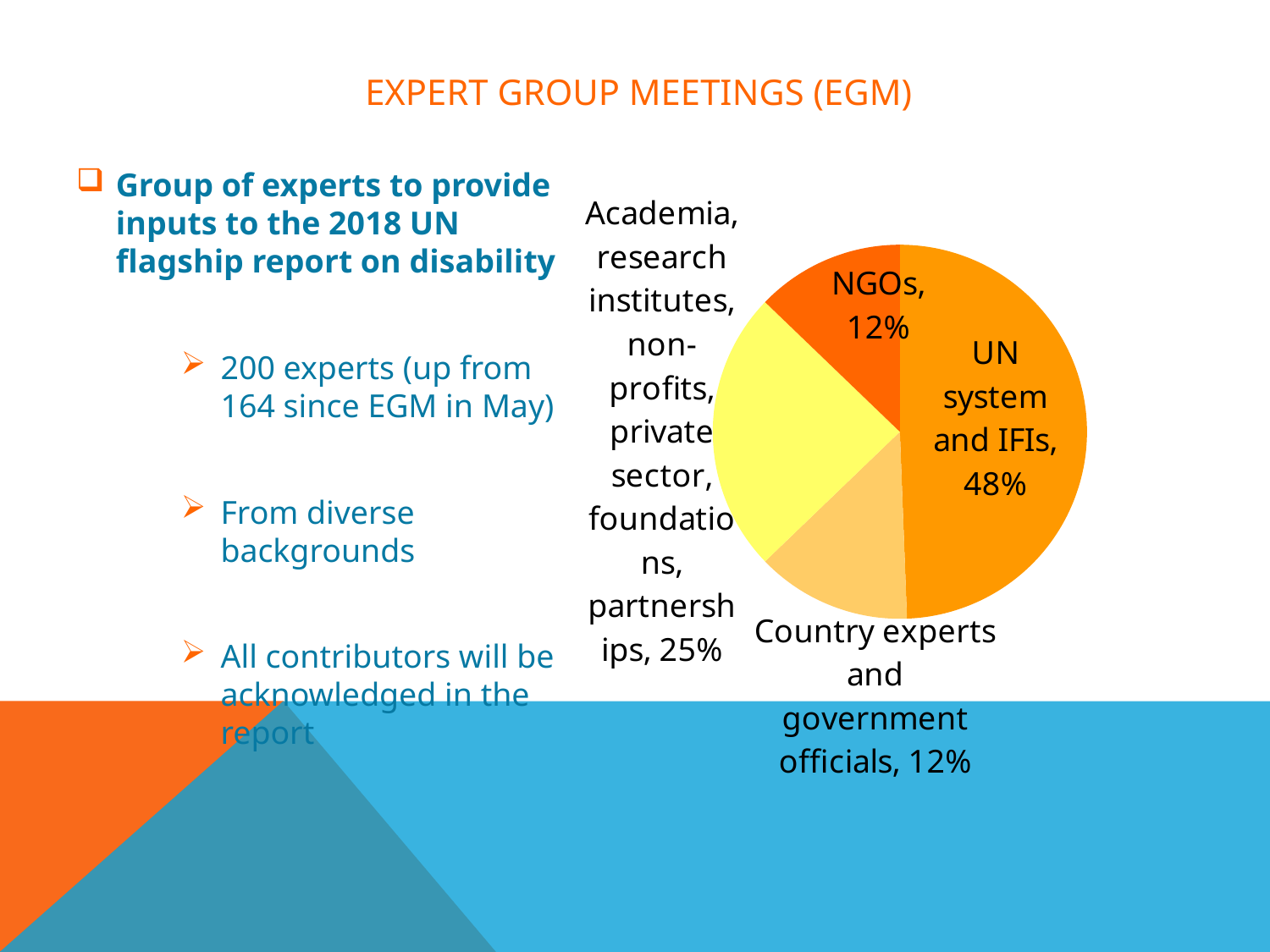
What is the difference in percentage points between the UN system and IFIs slice and the Academia, research institutes, non-profits, private sector, foundations, partnerships slice? 23% What percentage is shown for NGOs in the pie chart? 12% What kind of chart is shown on the slide? pie chart Which is larger: the UN system and IFIs slice or the Academia, research institutes, non-profits, private sector, foundations, partnerships slice? UN system and IFIs What colour is the UN system and IFIs slice in the pie chart? orange What is the difference in percentage points between the UN system and IFIs slice and the NGOs slice? 36% Which is larger: the NGOs slice or the Academia, research institutes, non-profits, private sector, foundations, partnerships slice? Academia, research institutes, non-profits, private sector, foundations, partnerships How many slices does the pie chart have? 4 What share of the pie is labelled for UN system and IFIs? 48% Which slice of the pie chart is the largest? UN system and IFIs What percentage is shown for Country experts and government officials? 12% What share is shown for the Academia, research institutes, non-profits, private sector, foundations, partnerships slice? 25%